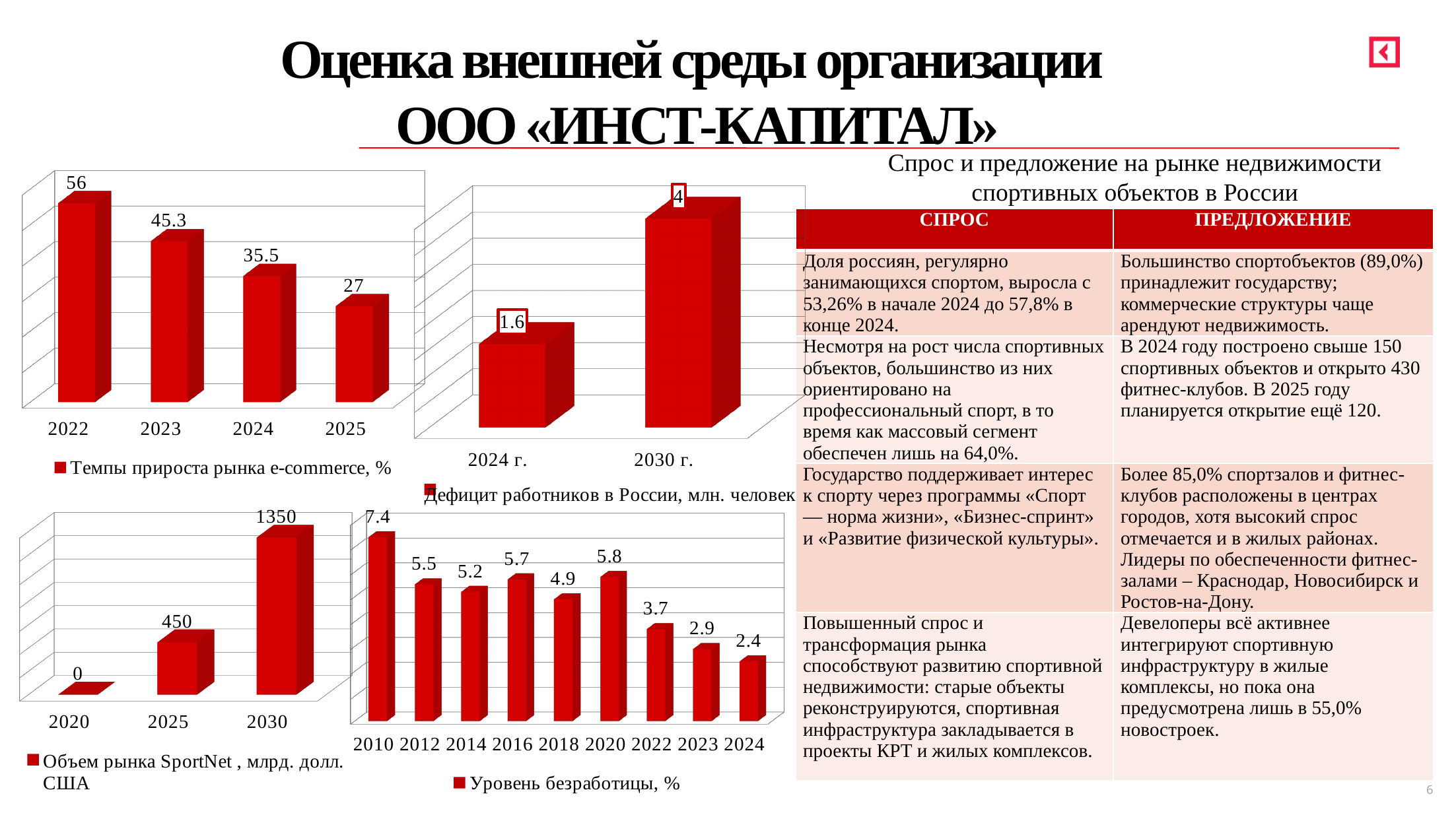
In the chart 'Темпы прироста рынка e-commerce, %', what is the value for 2023? 45.3 In the chart 'Объем рынка SportNet, млрд. долл. США', what is the value for 2025? 450 In the chart 'Уровень безработицы, %', which is larger: the value for 2016 or the value for 2020? 2020 In the chart 'Темпы прироста рынка e-commerce, %', which year has the lowest value? 2025 In the chart 'Уровень безработицы, %', what is the value for 2018? 4.9 In the chart 'Уровень безработицы, %', which year has the highest value? 2010 How many categories are shown in the chart 'Уровень безработицы, %'? 9 In the chart 'Объем рынка SportNet, млрд. долл. США', which year has the highest value? 2030 How many categories are shown in the chart 'Объем рынка SportNet, млрд. долл. США'? 3 In the chart 'Дефицит работников в России, млн. человек', what is the difference between the values for 2030 г. and 2024 г.? 2.4 In the chart 'Темпы прироста рынка e-commerce, %', do the values rise or fall from 2022 to 2025? fall In the chart 'Дефицит работников в России, млн. человек', what is the value for 2030 г.? 4